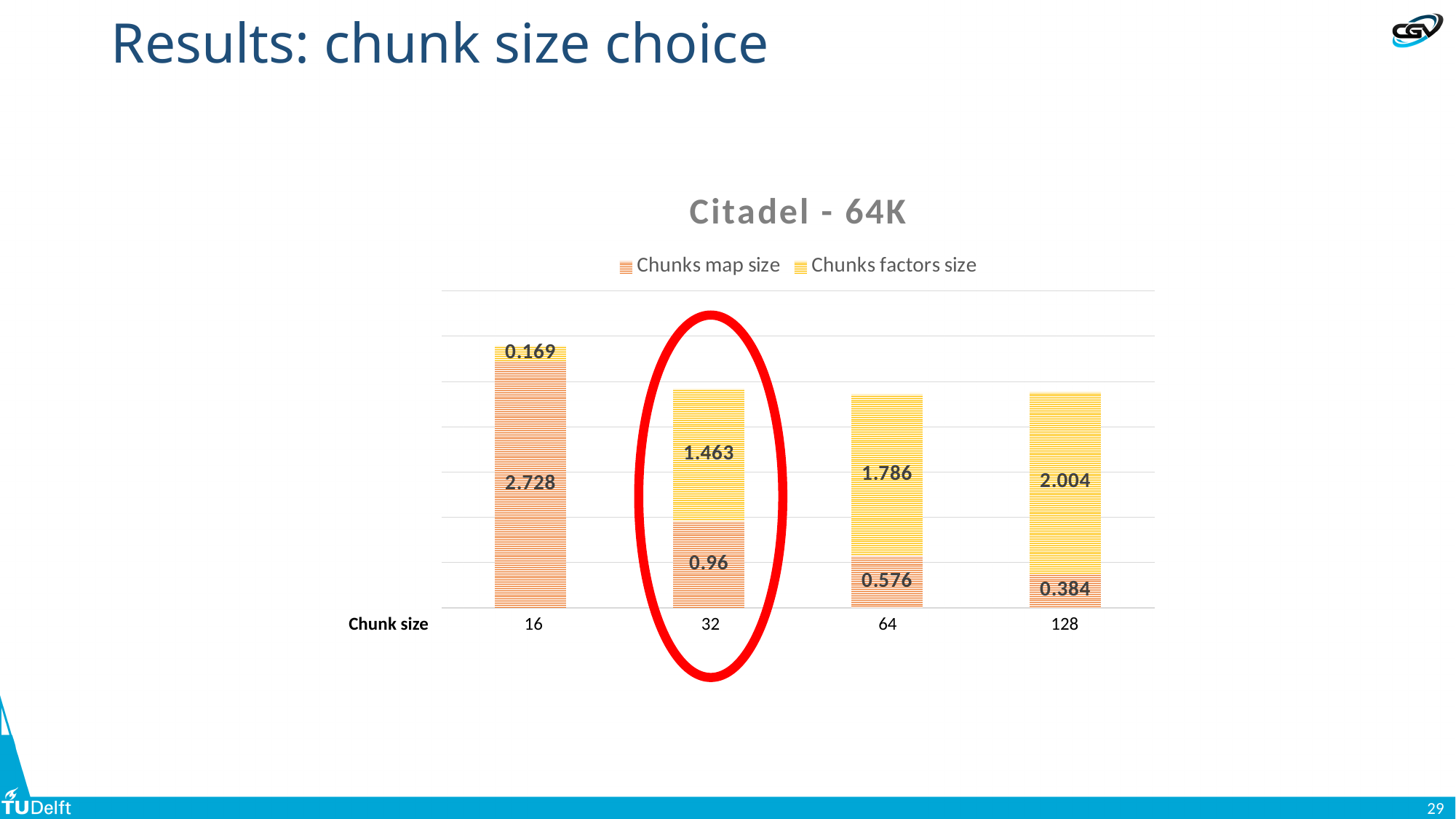
What is the Chunks map size for chunk size 128? 0.384 What is the Chunks factors size for chunk size 64? 1.786 What is the Chunks map size for chunk size 16? 2.728 What kind of chart is shown on the slide? Stacked bar chart How many series does the legend list? 2 Which chunk size has the highest Chunks map size? 16 What is the total of the stacked bar for chunk size 32? 2.423 What is the difference between the Chunks factors size for chunk size 128 and chunk size 64? 0.218 What is the Chunks factors size for chunk size 32? 1.463 How many chunk sizes are shown on the x axis? 4 Which is larger for chunk size 32: the Chunks map size or the Chunks factors size? Chunks factors size Which chunk size has the lowest Chunks factors size? 16